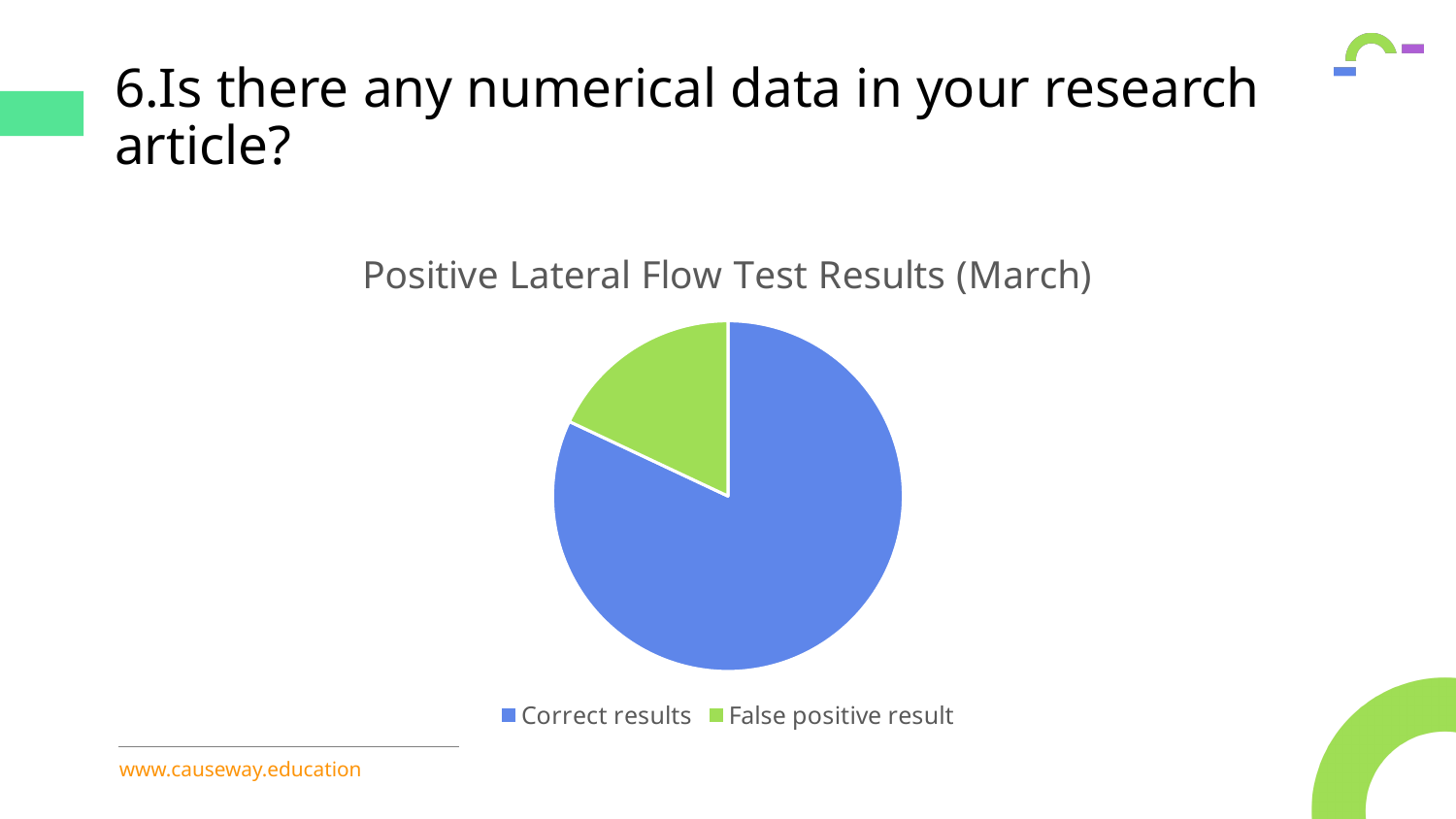
What is the title of the chart? Positive Lateral Flow Test Results (March) How many entries does the legend list? 2 Which category has the smallest slice of the pie? False positive result What kind of chart is shown on the slide? Pie chart How many slices does the pie chart have? 2 Which category has the largest slice of the pie? Correct results Which is larger, the slice for Correct results or the slice for False positive result? Correct results What colour is the slice for False positive result? Green